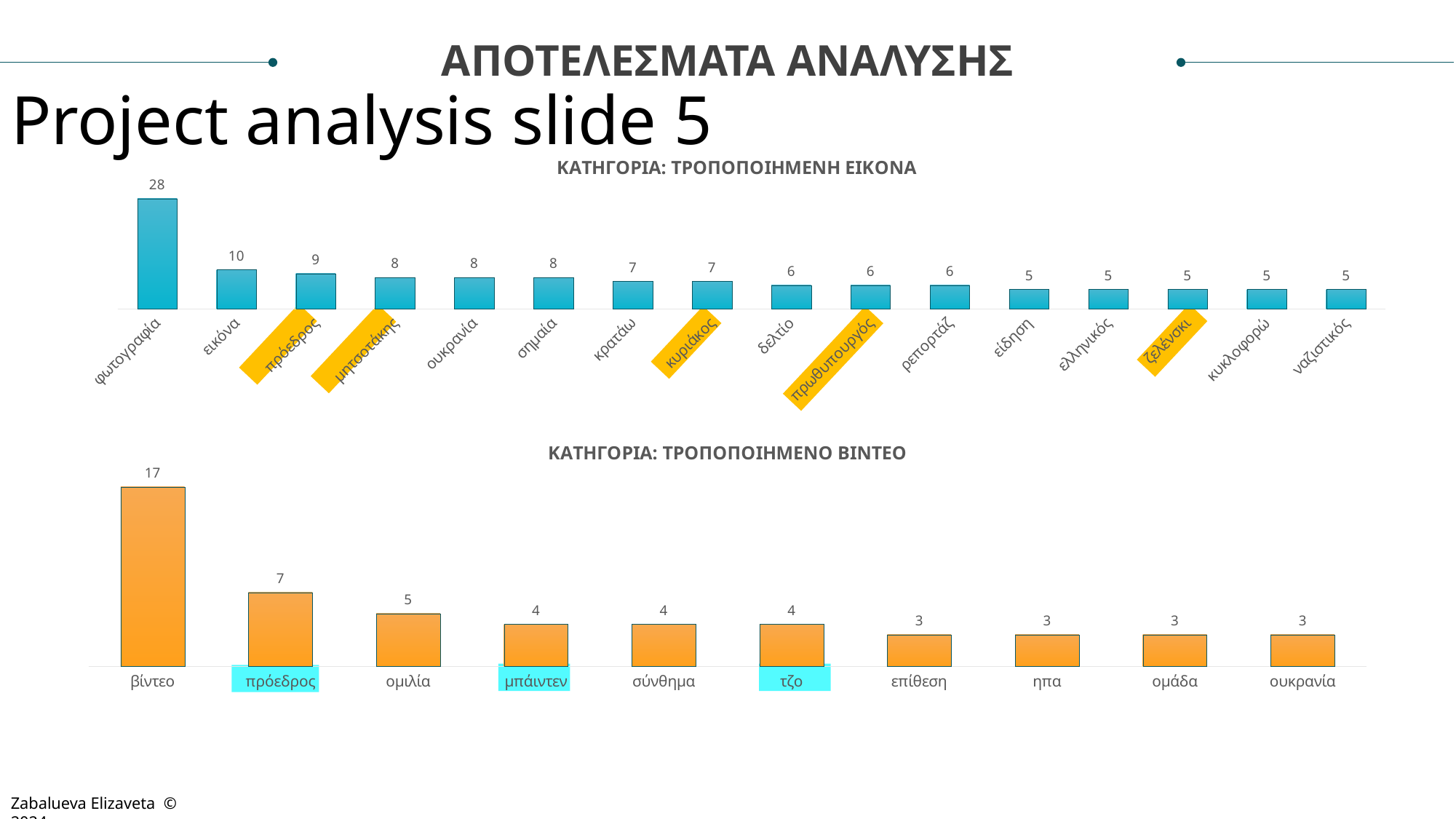
In the chart titled ΚΑΤΗΓΟΡΙΑ: ΤΡΟΠΟΠΟΙΗΜΕΝΗ ΕΙΚΟΝΑ, which category has the highest value? φωτογραφία In the chart titled ΚΑΤΗΓΟΡΙΑ: ΤΡΟΠΟΠΟΙΗΜΕΝΗ ΕΙΚΟΝΑ, which is larger, the value for πρόεδρος or the value for κρατάω? πρόεδρος In the chart titled ΚΑΤΗΓΟΡΙΑ: ΤΡΟΠΟΠΟΙΗΜΕΝΟ ΒΙΝΤΕΟ, what is the value for βίντεο? 17 In the chart titled ΚΑΤΗΓΟΡΙΑ: ΤΡΟΠΟΠΟΙΗΜΕΝΟ ΒΙΝΤΕΟ, do the values rise or fall from left to right? fall In the chart titled ΚΑΤΗΓΟΡΙΑ: ΤΡΟΠΟΠΟΙΗΜΕΝΗ ΕΙΚΟΝΑ, what is the value for εικόνα? 10 In the chart titled ΚΑΤΗΓΟΡΙΑ: ΤΡΟΠΟΠΟΙΗΜΕΝΟ ΒΙΝΤΕΟ, how many categories are shown? 10 In the chart titled ΚΑΤΗΓΟΡΙΑ: ΤΡΟΠΟΠΟΙΗΜΕΝΗ ΕΙΚΟΝΑ, what is the value for φωτογραφία? 28 In the chart titled ΚΑΤΗΓΟΡΙΑ: ΤΡΟΠΟΠΟΙΗΜΕΝΟ ΒΙΝΤΕΟ, what is the difference between the values for βίντεο and ομιλία? 12 What kind of chart is the chart titled ΚΑΤΗΓΟΡΙΑ: ΤΡΟΠΟΠΟΙΗΜΕΝΟ ΒΙΝΤΕΟ? bar chart In the chart titled ΚΑΤΗΓΟΡΙΑ: ΤΡΟΠΟΠΟΙΗΜΕΝΗ ΕΙΚΟΝΑ, how many categories are shown? 16 In the chart titled ΚΑΤΗΓΟΡΙΑ: ΤΡΟΠΟΠΟΙΗΜΕΝΟ ΒΙΝΤΕΟ, what is the value for πρόεδρος? 7 In the chart titled ΚΑΤΗΓΟΡΙΑ: ΤΡΟΠΟΠΟΙΗΜΕΝΗ ΕΙΚΟΝΑ, what is the difference between the values for φωτογραφία and εικόνα? 18